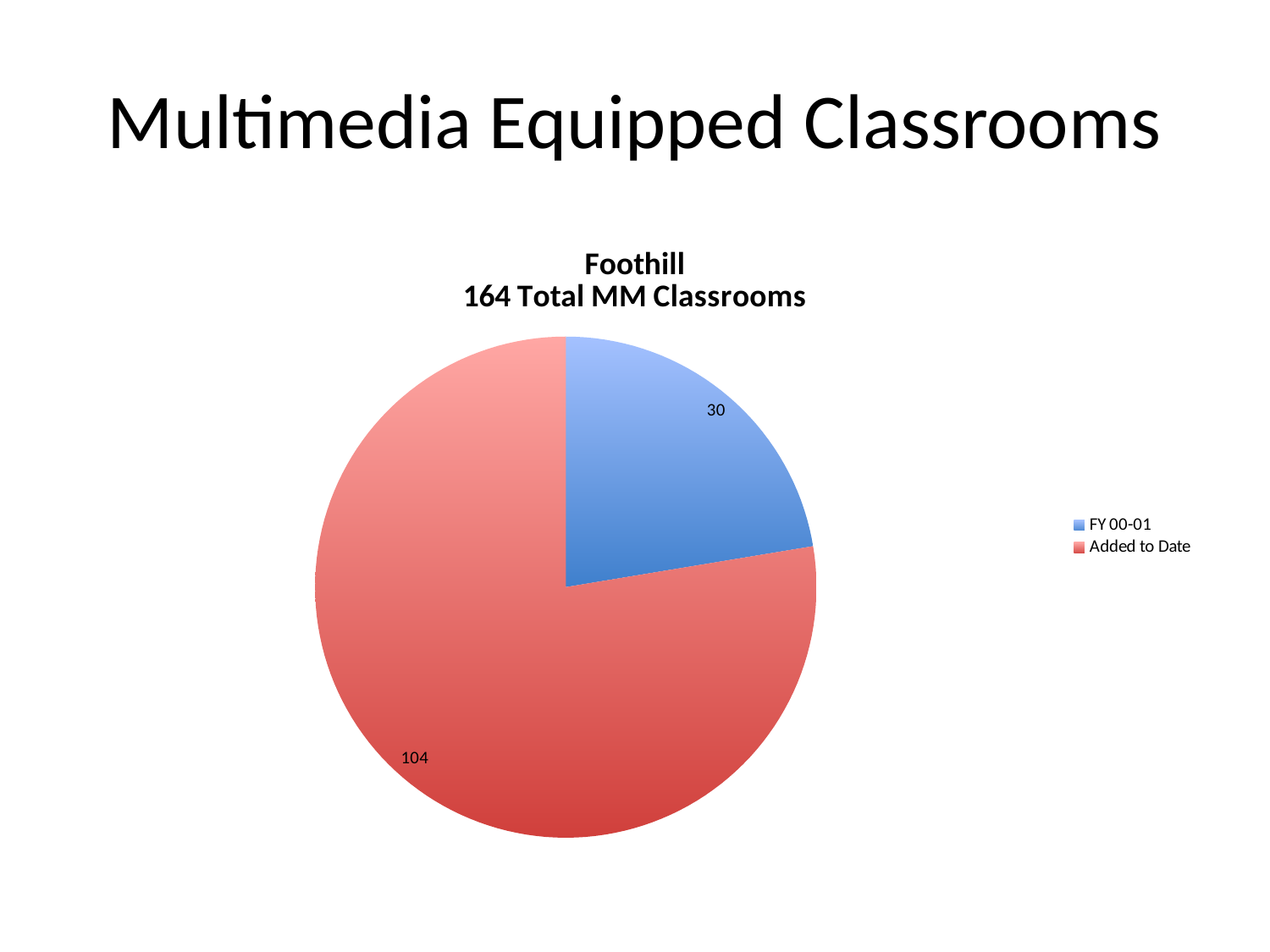
What is the value of the Added to Date slice? 104 What is the difference between the Added to Date value and the FY 00-01 value? 74 How many slices does the pie chart have? 2 Which is larger, the FY 00-01 slice or the Added to Date slice? Added to Date Which slice is the smallest? FY 00-01 What is the value of the FY 00-01 slice? 30 Which slice is the largest? Added to Date What colour is the Added to Date slice? Red How many entries does the legend list? 2 What is the title of the chart? Foothill 164 Total MM Classrooms What kind of chart is shown on the slide? Pie chart